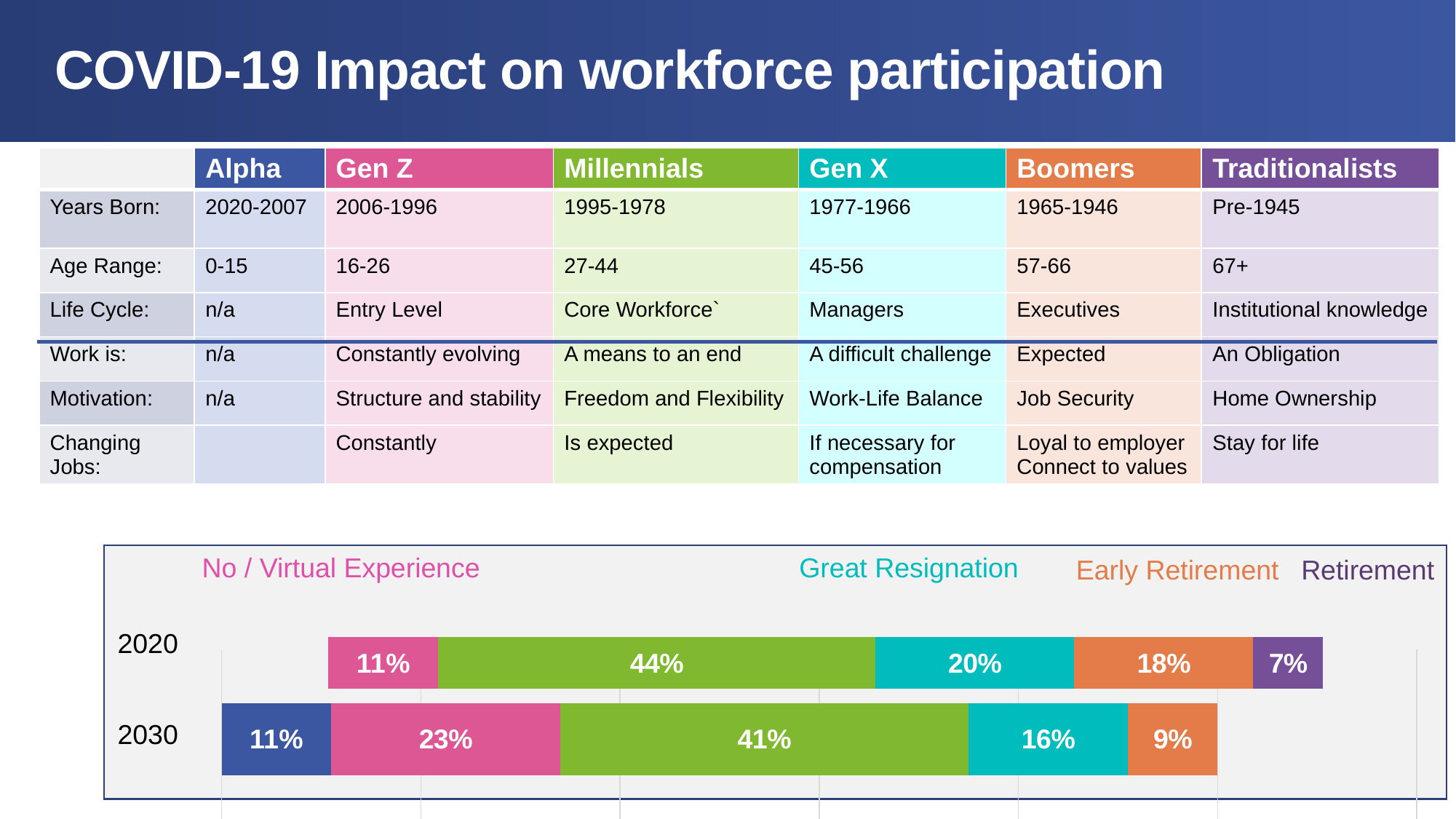
In the chart, what is the value of the orange (Boomers) segment in the 2030 bar? 9% How many bars (years) does the chart at the bottom of the slide show? 2 In the chart, what is the total of all segments in the 2030 bar? 100% In the chart, what is the value of the green (Millennials) segment in the 2030 bar? 41% In the chart, what is the value of the green (Millennials) segment in the 2020 bar? 44% In the chart, what is the value of the pink (Gen Z) segment in the 2030 bar? 23% In the chart, what is the difference between the teal (Gen X) segment in 2020 and in 2030? 4% In the chart, which segment is the smallest in the 2030 bar? Orange (Boomers), 9% In the chart, which segment is the largest in the 2020 bar? Green (Millennials), 44% In the chart, is the pink (Gen Z) segment larger in 2020 or in 2030? 2030 In the chart, what is the value of the purple (Traditionalists) segment in the 2020 bar? 7% What type of chart is shown at the bottom of the slide? Stacked bar chart